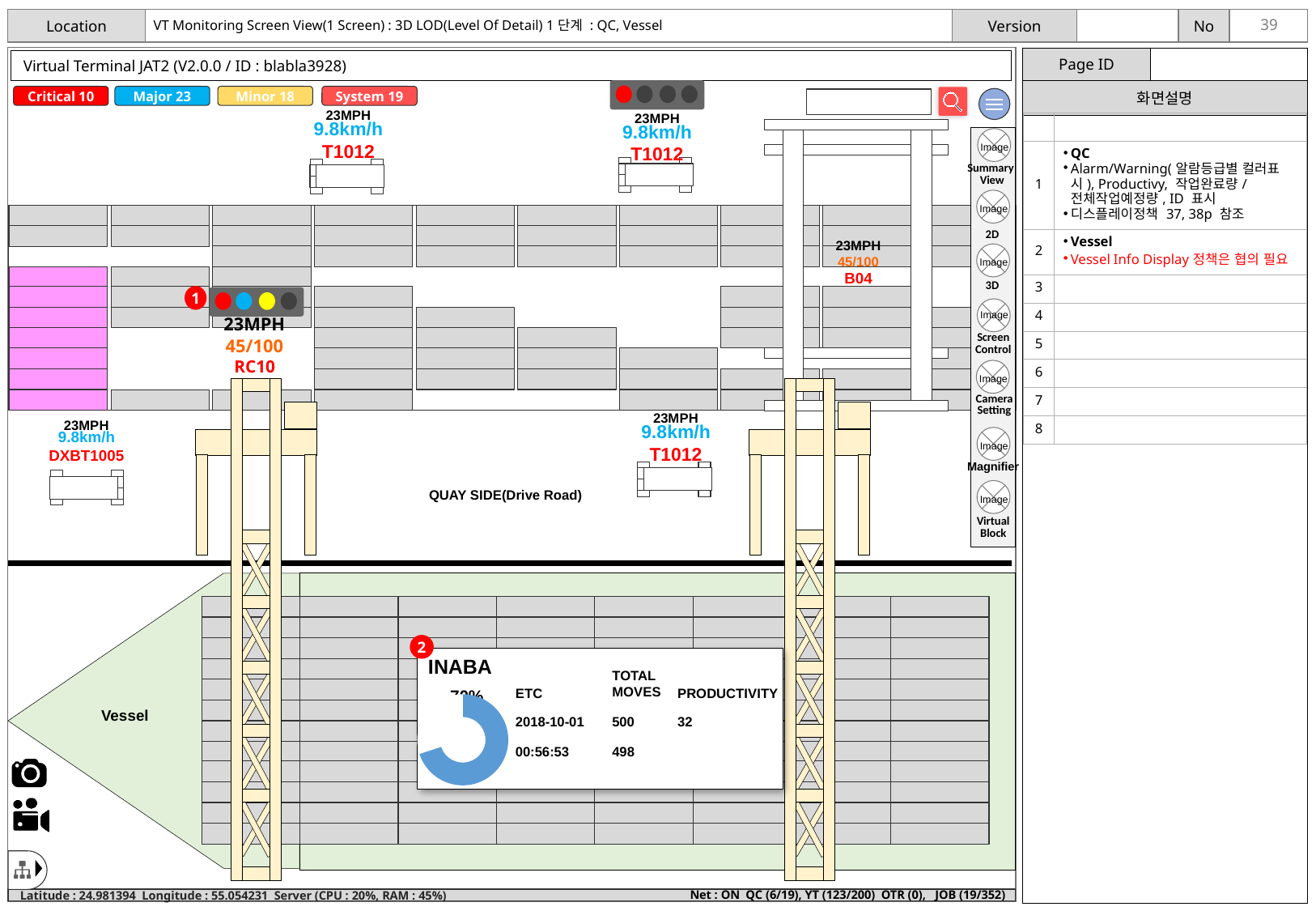
What kind of chart is shown in the INABA panel on the vessel? donut (pie) chart In the INABA panel, what PRODUCTIVITY value is shown? 32 In the INABA panel, what ETC date is shown? 2018-10-01 In the INABA panel, what is the TOTAL MOVES value shown on the second row? 498 In the INABA panel, what is the difference between the two TOTAL MOVES values, 500 and 498? 2 In the INABA panel, which TOTAL MOVES value is larger, the first row or the second row? first row (500) In the INABA panel, what ETC time is shown? 00:56:53 What name is shown as the title of the panel containing the donut chart? INABA What colour is the filled portion of the donut chart in the INABA panel? blue In the INABA panel, what is the TOTAL MOVES value shown on the first row? 500